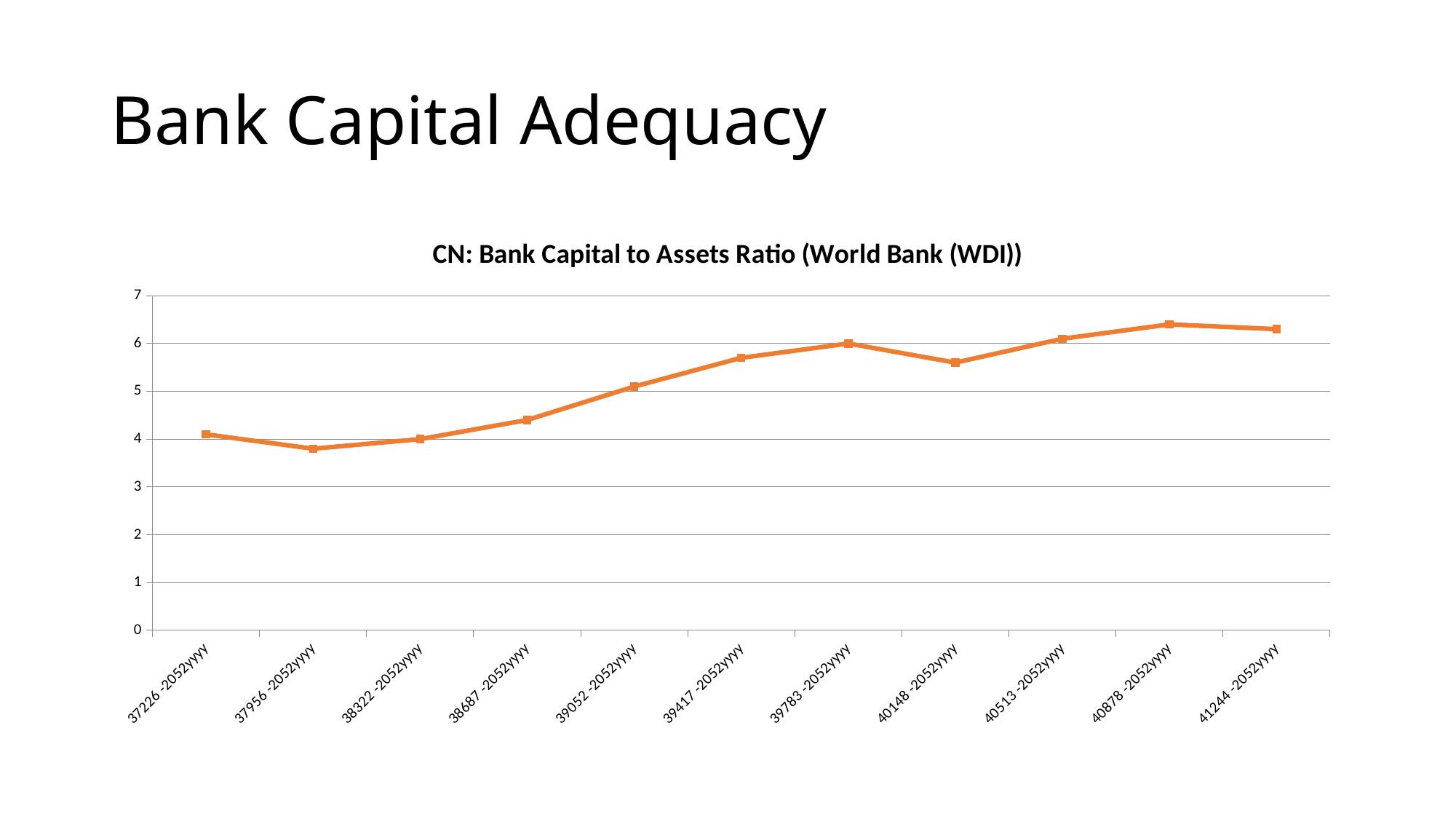
Is the value for 38687 -2052yyyy greater or less than 5? less What colour is the plotted line? orange Is the value for 40878 -2052yyyy greater or less than 6? greater Which category has the lowest value? 37956 -2052yyyy How many data points are plotted on the line? 11 What kind of chart is shown on the slide? line chart What is the title of the chart? CN: Bank Capital to Assets Ratio (World Bank (WDI)) Is the value for 37956 -2052yyyy greater or less than 4? less Overall, do the values rise or fall from the first category to the last? rise Which is larger, the value for 39783 -2052yyyy or the value for 40148 -2052yyyy? 39783 -2052yyyy Which is larger, the value for 38687 -2052yyyy or the value for 39417 -2052yyyy? 39417 -2052yyyy